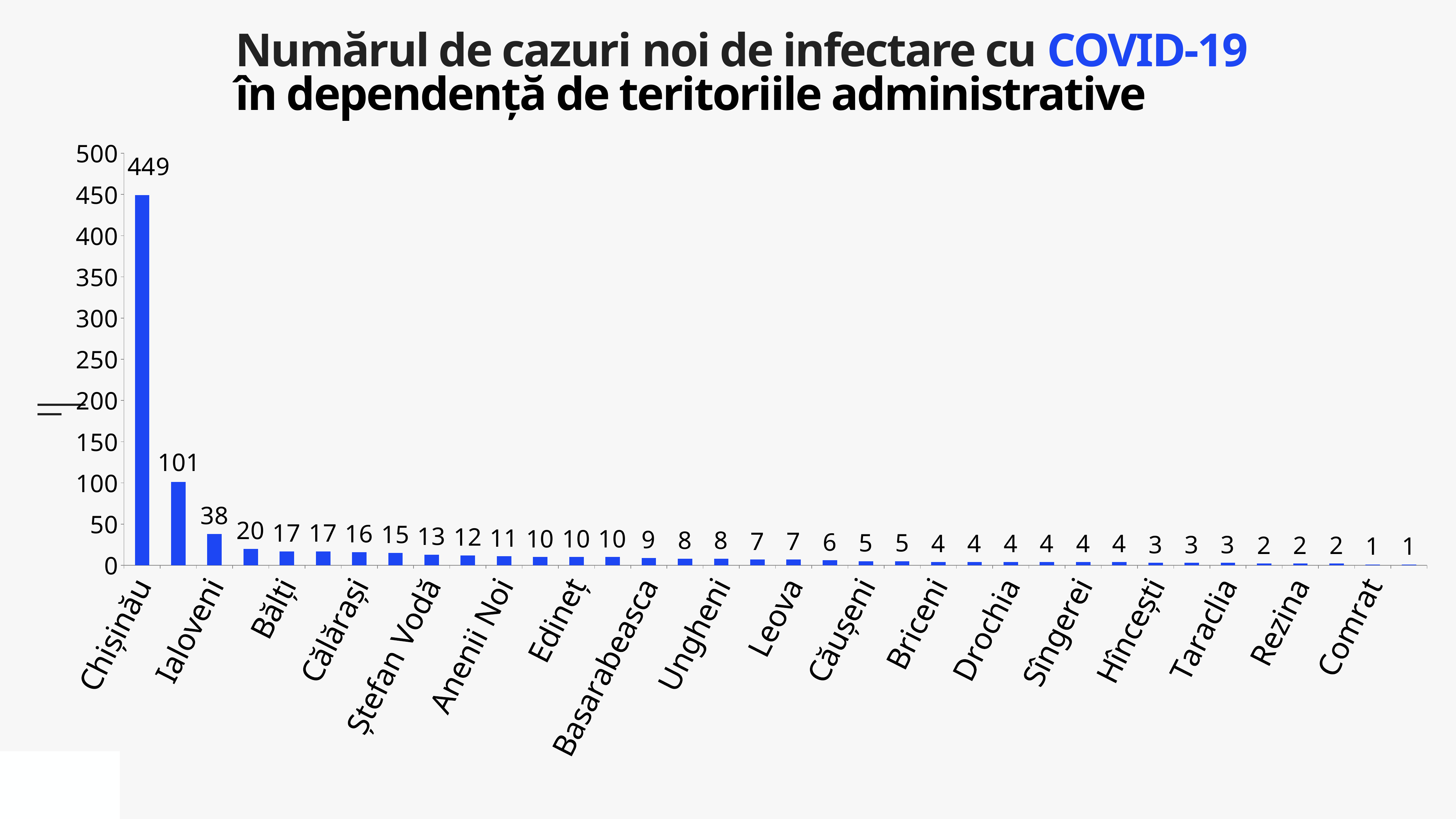
How many new COVID-19 cases are shown for Căușeni? 5 How many new COVID-19 cases are shown for Chișinău? 449 What type of chart is shown on the slide? bar chart Which administrative territory has the highest number of new COVID-19 cases? Chișinău What is the difference between the number of cases in Chișinău and in Bălți? 432 Is the value for Chișinău greater or less than 400? greater How many new COVID-19 cases are shown for Comrat? 1 How many new COVID-19 cases are shown for Edineț? 10 How many new COVID-19 cases are shown for Bălți? 17 Is the value for Ialoveni greater or less than 50? less Do the bar values rise or fall from left to right along the x axis? fall Which has more new cases, Chișinău or Ialoveni? Chișinău